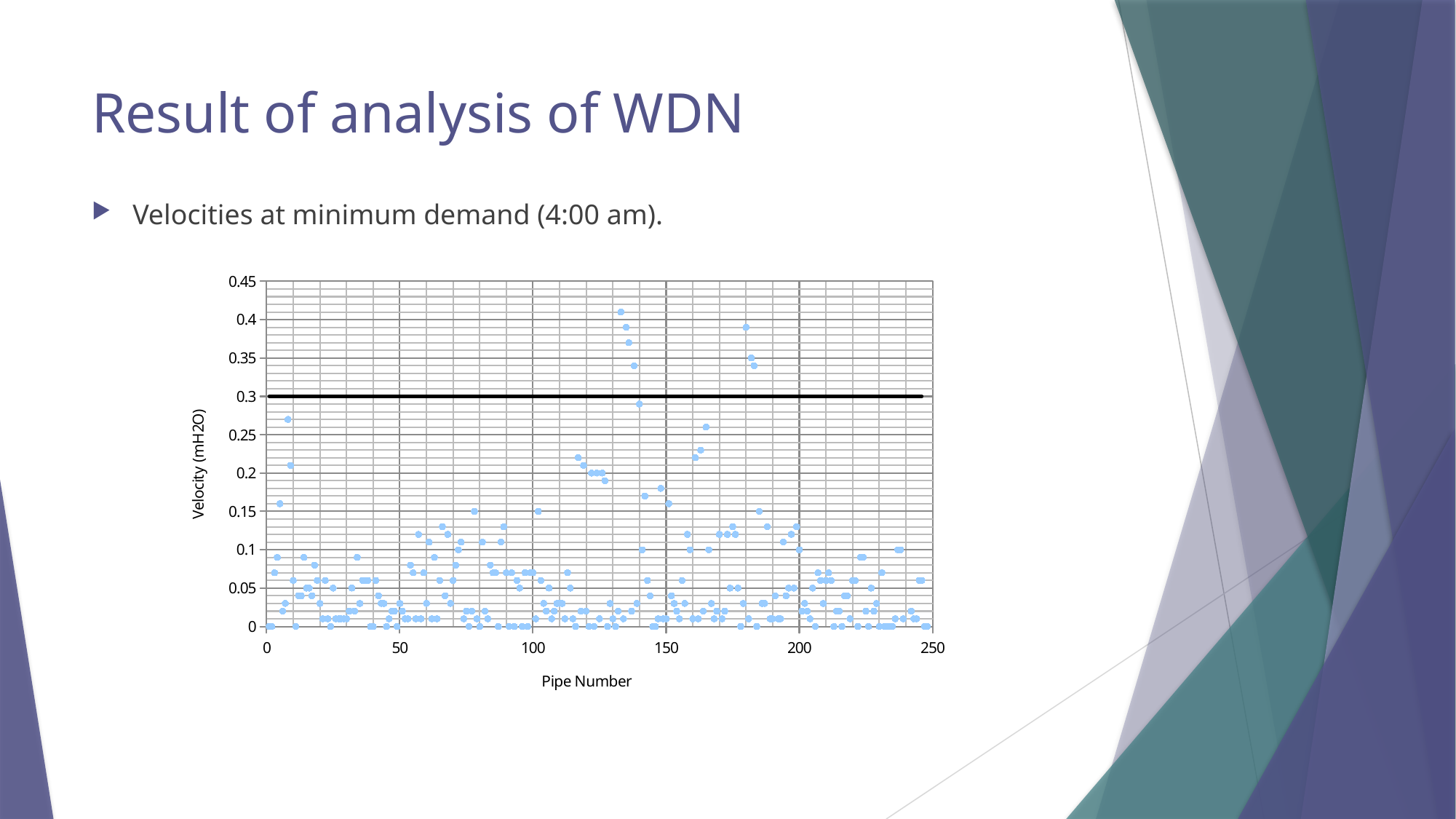
Is the plotted velocity for the pipe near number 180 greater or less than 0.35? greater At what velocity value is the horizontal black line drawn across the chart? 0.3 What is the highest value shown on the horizontal axis? 250 Is the highest plotted velocity greater or less than 0.35? greater What is the highest value shown on the vertical axis? 0.45 Is the lowest plotted velocity greater or less than 0.05? less What is the label of the vertical axis of the chart? Velocity (mH2O) What kind of chart is shown on the slide? Scatter chart